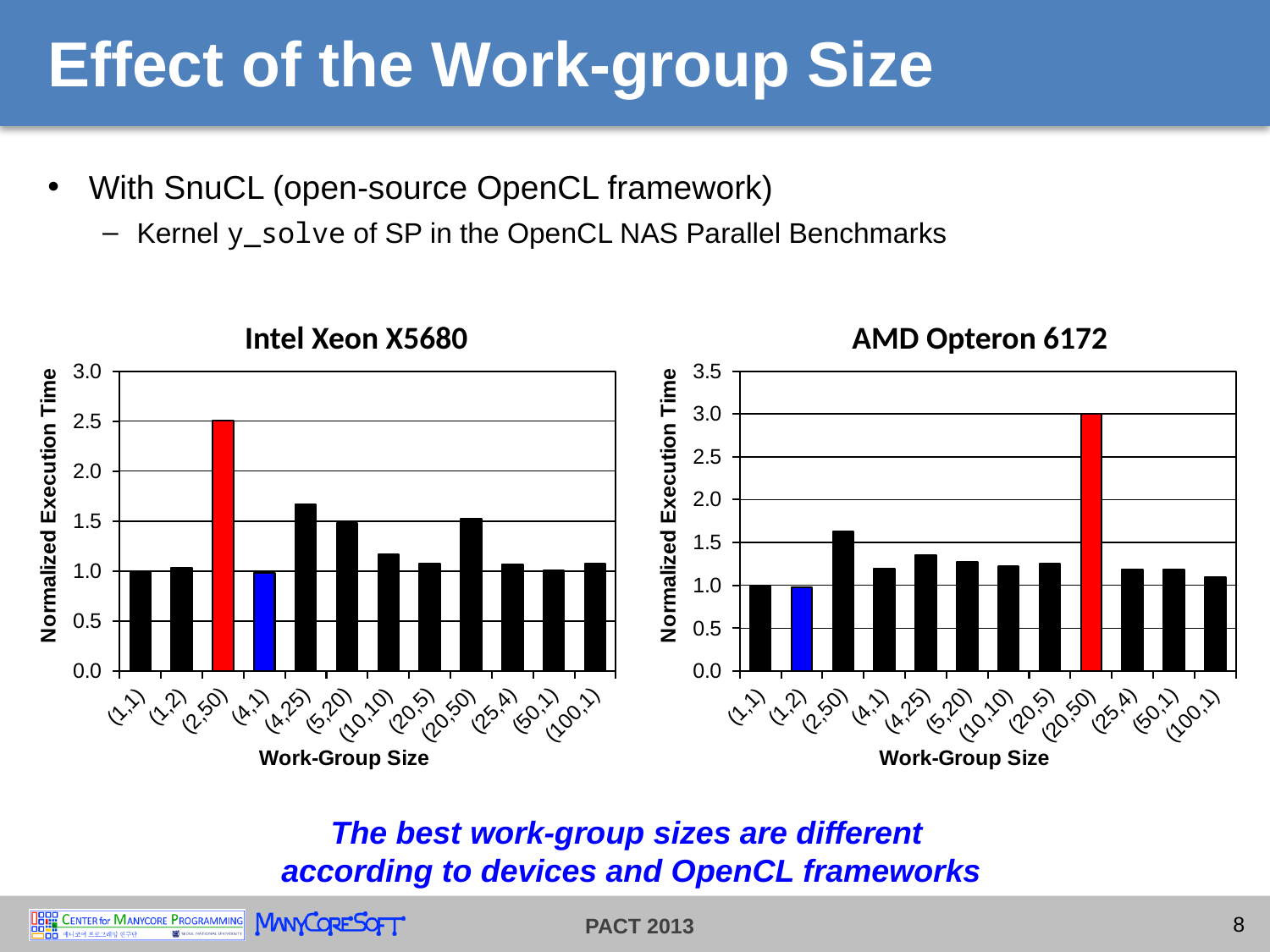
In the AMD Opteron 6172 chart, which work-group size has the highest normalized execution time? (20,50) How many work-group sizes are shown on the x axis of the AMD Opteron 6172 chart? 12 In the AMD Opteron 6172 chart, is the value for (100,1) greater or less than 1.5? less What type of chart is the Intel Xeon X5680 chart? bar chart What is the y-axis label of the AMD Opteron 6172 chart? Normalized Execution Time In the AMD Opteron 6172 chart, is the value for (2,50) greater or less than 1.5? greater In the Intel Xeon X5680 chart, which is larger, the value for (4,25) or the value for (10,10)? (4,25) In the Intel Xeon X5680 chart, is the value for (2,50) greater or less than 2.0? greater In the AMD Opteron 6172 chart, which is larger, the value for (2,50) or the value for (4,1)? (2,50) What is the x-axis label of the Intel Xeon X5680 chart? Work-Group Size In the Intel Xeon X5680 chart, which work-group size has the highest normalized execution time? (2,50)